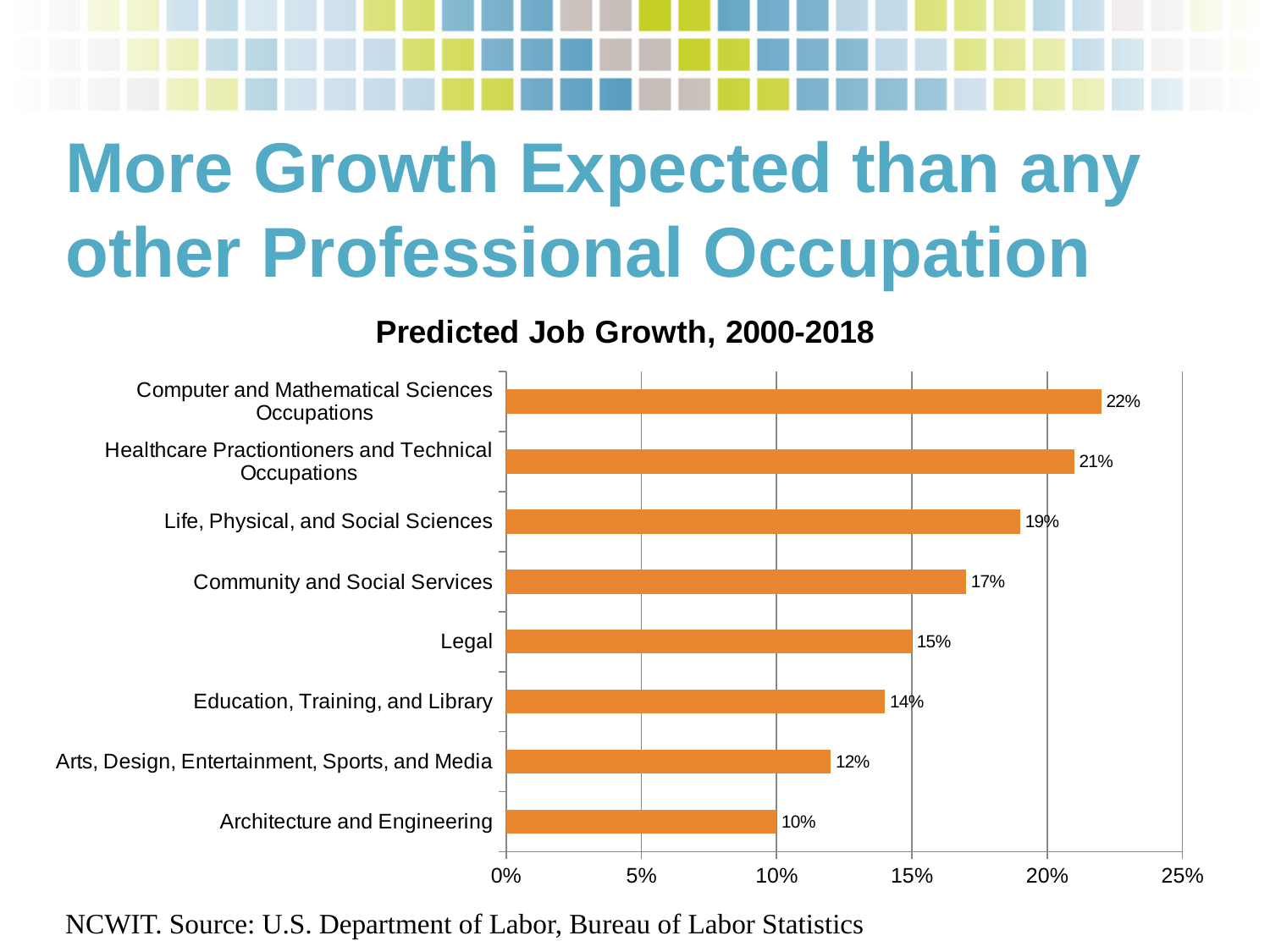
What is the title of the chart? Predicted Job Growth, 2000-2018 Which has higher predicted job growth, Education, Training, and Library or Legal? Legal What is the predicted job growth for Computer and Mathematical Sciences Occupations? 22% What is the difference in predicted job growth between Life, Physical, and Social Sciences and Community and Social Services? 2% What is the predicted job growth for Arts, Design, Entertainment, Sports, and Media? 12% How many occupation categories are shown in the chart? 8 Is the value for Healthcare Practiontioners and Technical Occupations greater or less than 20%? greater What is the predicted job growth for Legal? 15% Which category has the highest predicted job growth? Computer and Mathematical Sciences Occupations What is the difference in predicted job growth between Computer and Mathematical Sciences Occupations and Architecture and Engineering? 12% Which category has the lowest predicted job growth? Architecture and Engineering What kind of chart is shown on the slide? Bar chart